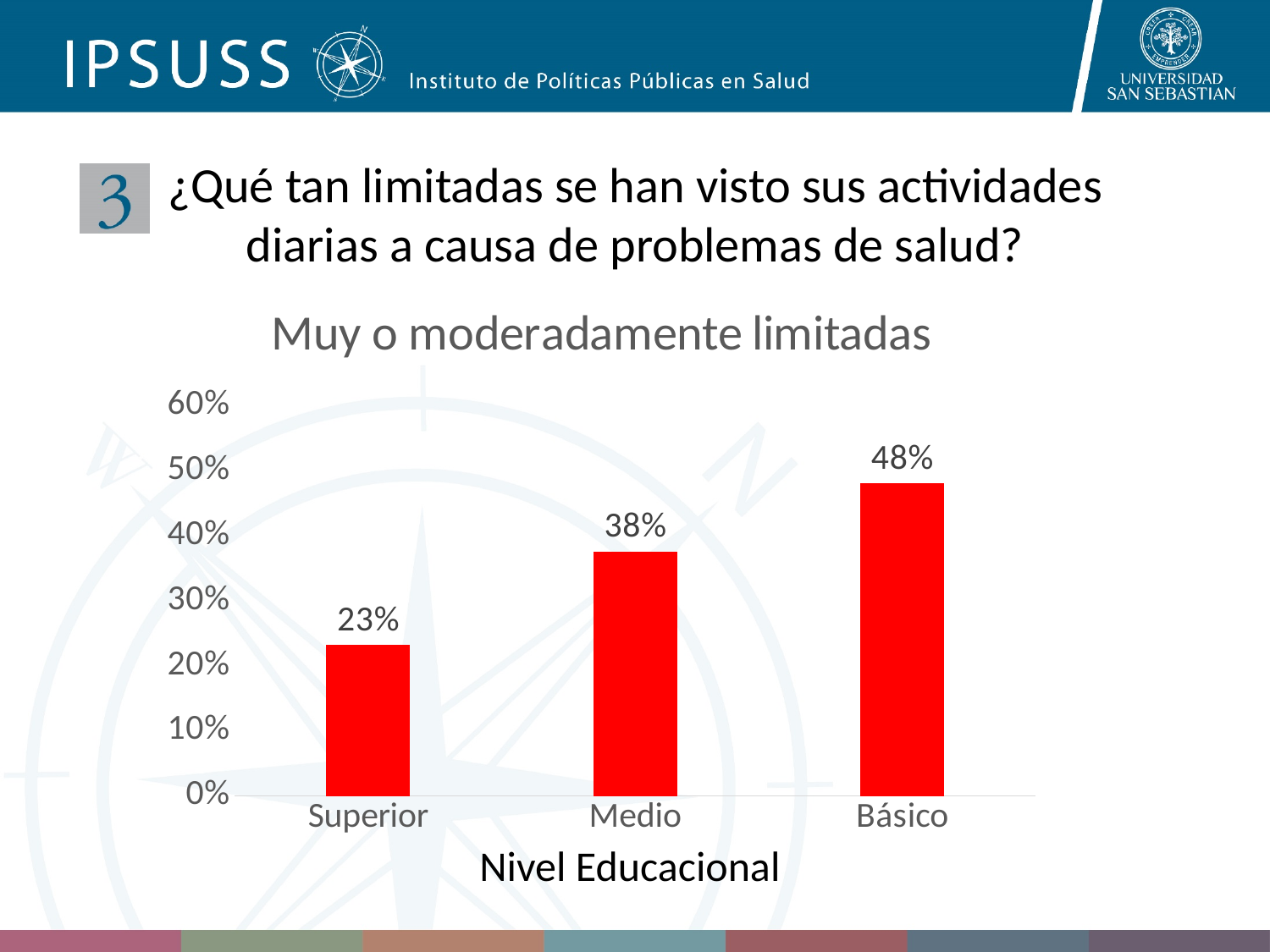
What is the title of the chart? Muy o moderadamente limitadas Which educational level has the lowest value? Superior Is the value for Básico greater or less than 40%? greater What is the difference between the values for Básico and Superior? 25% What kind of chart is shown on the slide? bar chart Which is larger, the value for Medio or the value for Superior? Medio What is the difference between the values for Medio and Superior? 15% What is the value for Básico? 48% Which educational level has the highest value? Básico What is the value for Superior? 23% What is the value for Medio? 38% How many educational levels are shown on the x axis? 3